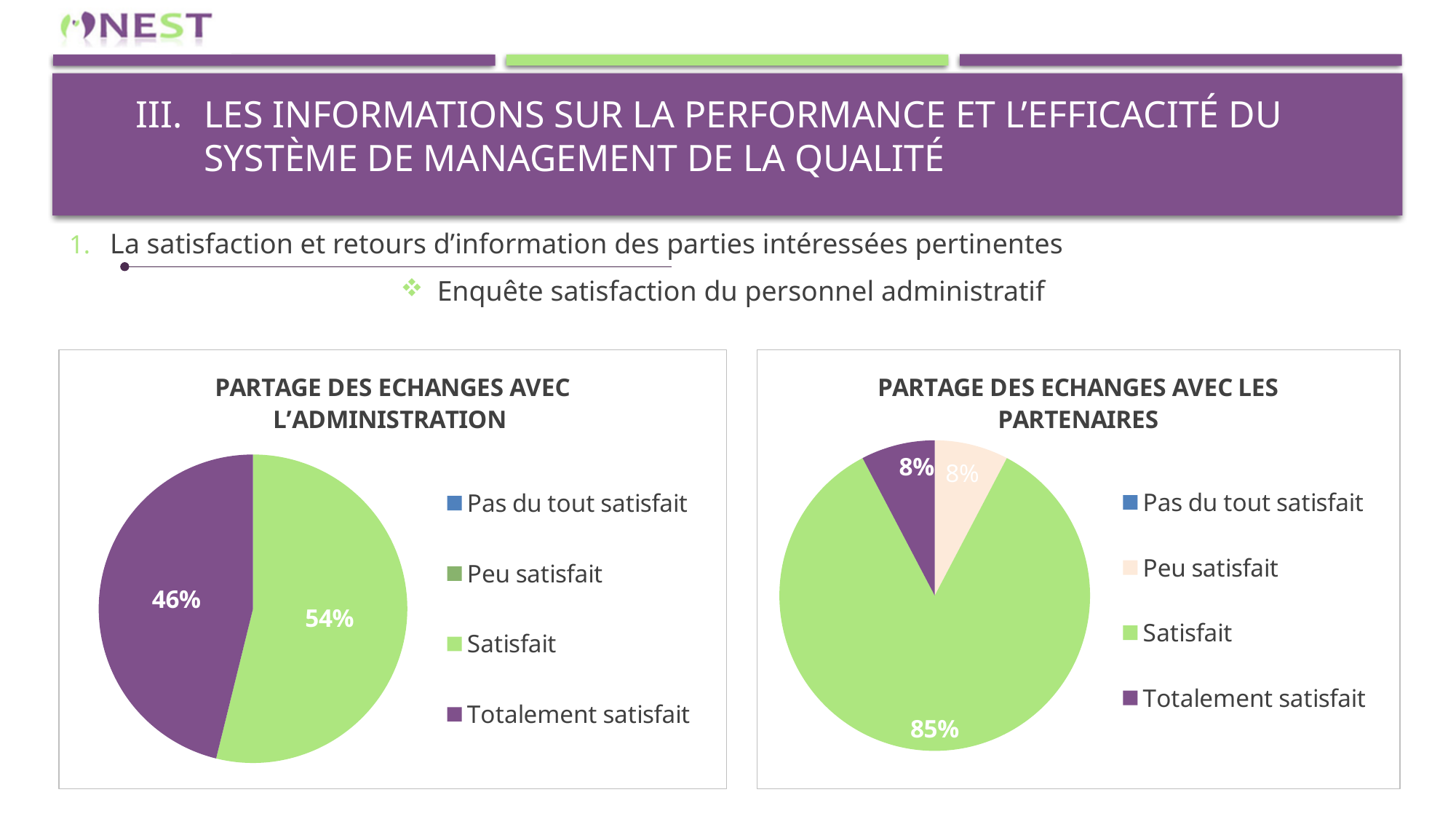
In the chart titled "PARTAGE DES ECHANGES AVEC LES PARTENAIRES", what share is labelled for Satisfait? 85% In the chart titled "PARTAGE DES ECHANGES AVEC LES PARTENAIRES", what share is labelled for Totalement satisfait? 8% In the chart titled "PARTAGE DES ECHANGES AVEC L'ADMINISTRATION", what share is labelled for Satisfait? 54% In the chart titled "PARTAGE DES ECHANGES AVEC LES PARTENAIRES", what share is labelled for Peu satisfait? 8% In the chart titled "PARTAGE DES ECHANGES AVEC L'ADMINISTRATION", which category has the largest slice? Satisfait How many entries does the legend of the chart titled "PARTAGE DES ECHANGES AVEC LES PARTENAIRES" list? 4 In the chart titled "PARTAGE DES ECHANGES AVEC L'ADMINISTRATION", what share is labelled for Totalement satisfait? 46% In the chart titled "PARTAGE DES ECHANGES AVEC LES PARTENAIRES", what is the difference between the Satisfait share and the Totalement satisfait share? 77% In the chart titled "PARTAGE DES ECHANGES AVEC LES PARTENAIRES", which category has the largest slice? Satisfait What type of chart is the chart titled "PARTAGE DES ECHANGES AVEC L'ADMINISTRATION"? Pie chart In the chart titled "PARTAGE DES ECHANGES AVEC L'ADMINISTRATION", what is the difference between the Satisfait and Totalement satisfait shares? 8% Which is larger: the Satisfait share in the chart titled "PARTAGE DES ECHANGES AVEC L'ADMINISTRATION" or the Satisfait share in the chart titled "PARTAGE DES ECHANGES AVEC LES PARTENAIRES"? PARTAGE DES ECHANGES AVEC LES PARTENAIRES